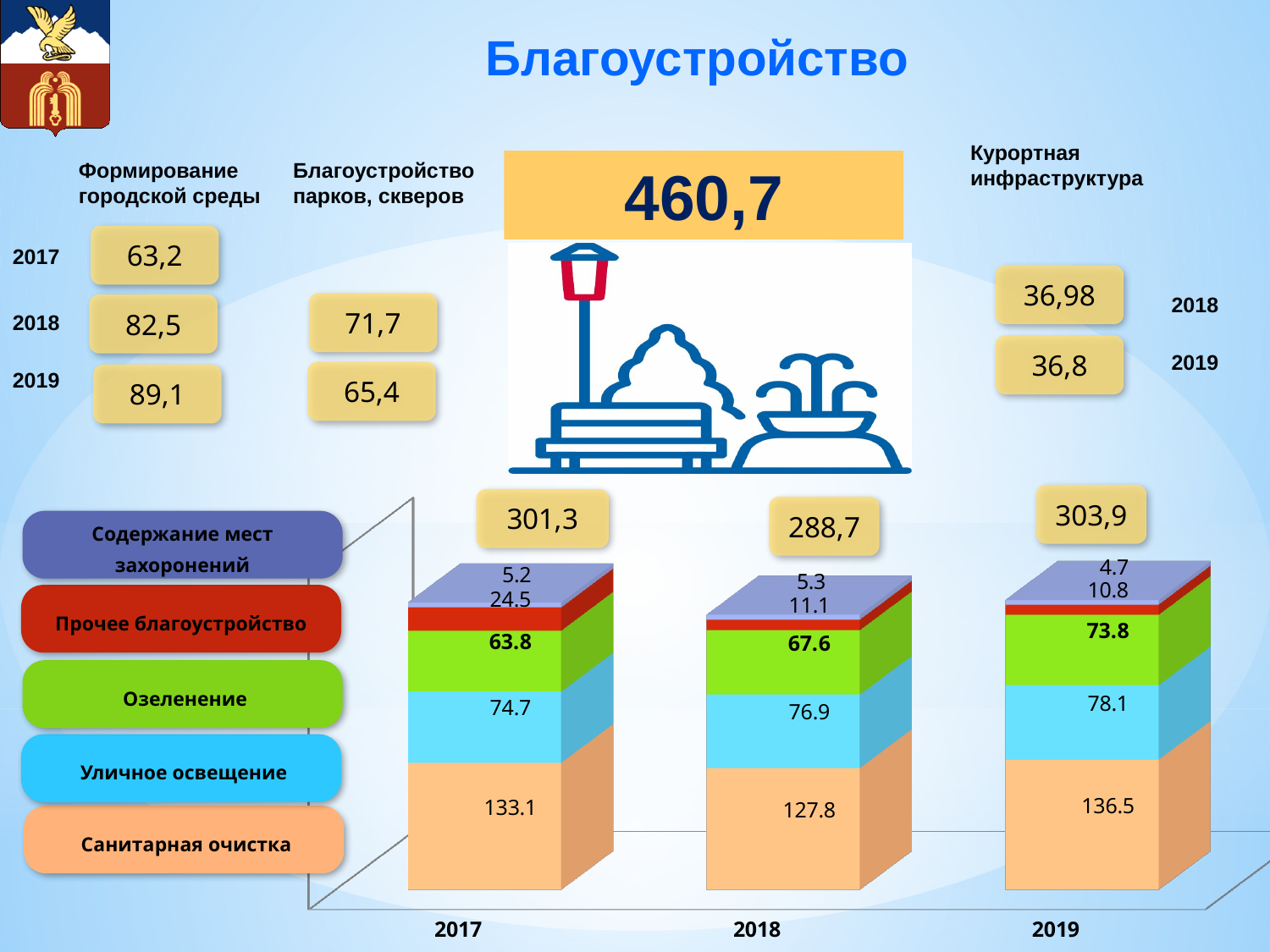
What kind of chart is shown at the bottom of the slide? Stacked bar chart In which year is the value for Озеленение the highest on the stacked bar chart? 2019 What is the value for Озеленение in 2018 on the stacked bar chart? 67.6 How many years are shown on the x axis of the stacked bar chart? 3 What is the value for Санитарная очистка in 2019 on the stacked bar chart? 136.5 What is the total of the stacked bar for 2018? 288,7 In which year is the value for Санитарная очистка the lowest on the stacked bar chart? 2018 Which is larger on the stacked bar chart: Уличное освещение in 2017 or in 2018? 2018 What is the value for Прочее благоустройство in 2017 on the stacked bar chart? 24.5 What is the value for Уличное освещение in 2019 on the stacked bar chart? 78.1 How many series does the stacked bar chart show? 5 What is the difference between the Прочее благоустройство values for 2017 and 2018 on the stacked bar chart? 13.4